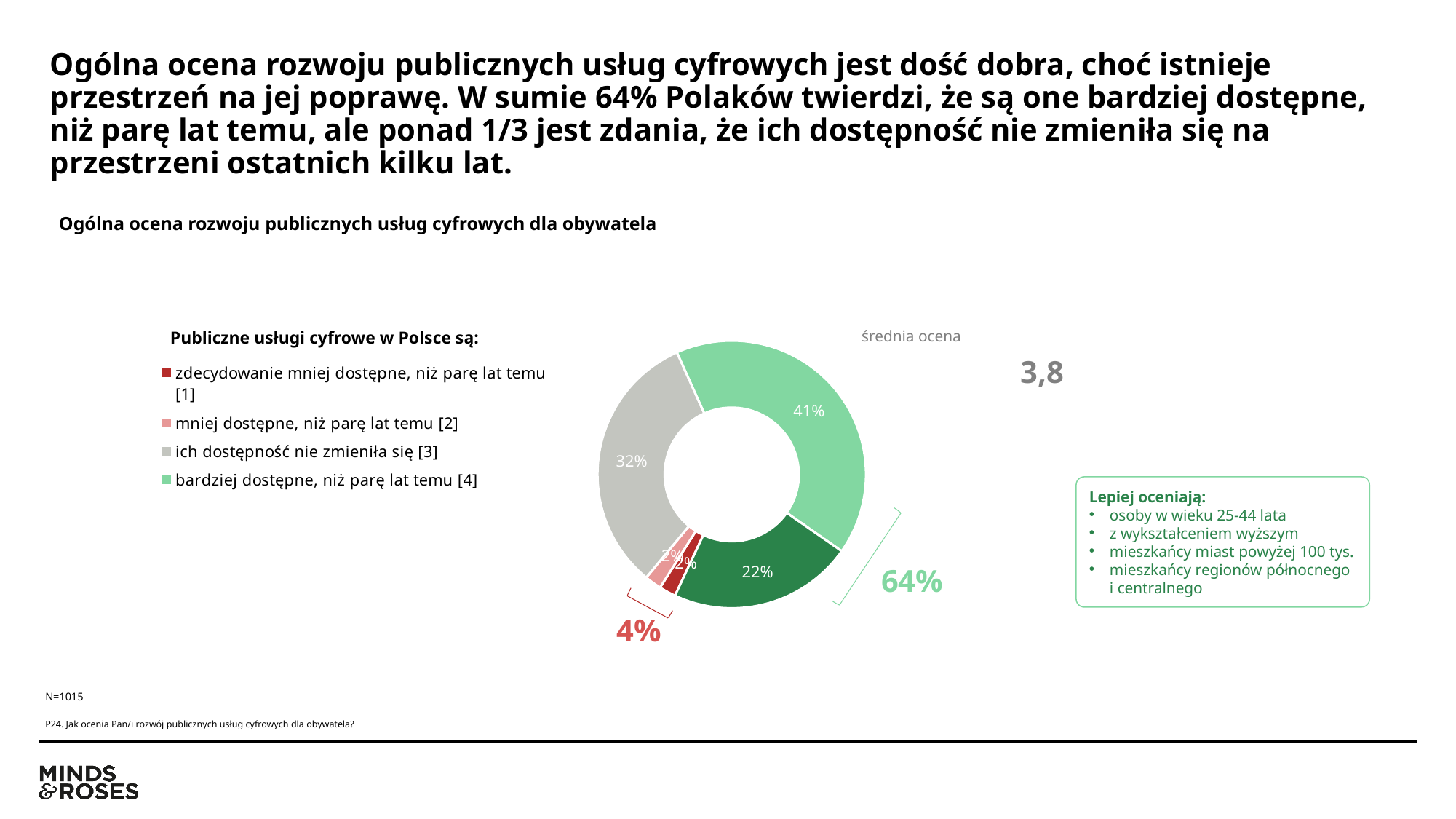
How many entries does the legend list? 4 What is the difference between the 41% slice and the 32% slice? 9 percentage points What percentage is shown on the dark green slice of the donut chart? 22% Which slice is larger: the grey "ich dostępność nie zmieniła się [3]" slice or the dark green 22% slice? ich dostępność nie zmieniła się [3] How many slices does the donut chart have? 5 What type of chart is shown on the slide? Donut (pie) chart Which category has the largest slice in the donut chart? bardziej dostępne, niż parę lat temu [4] What combined percentage is shown for the two green slices together? 64% What percentage is shown for "mniej dostępne, niż parę lat temu [2]"? 2% What percentage of respondents say public digital services are "ich dostępność nie zmieniła się [3]"? 32% What percentage is shown for the light green slice "bardziej dostępne, niż parę lat temu [4]"? 41% What is the average rating ("średnia ocena") shown next to the chart? 3,8